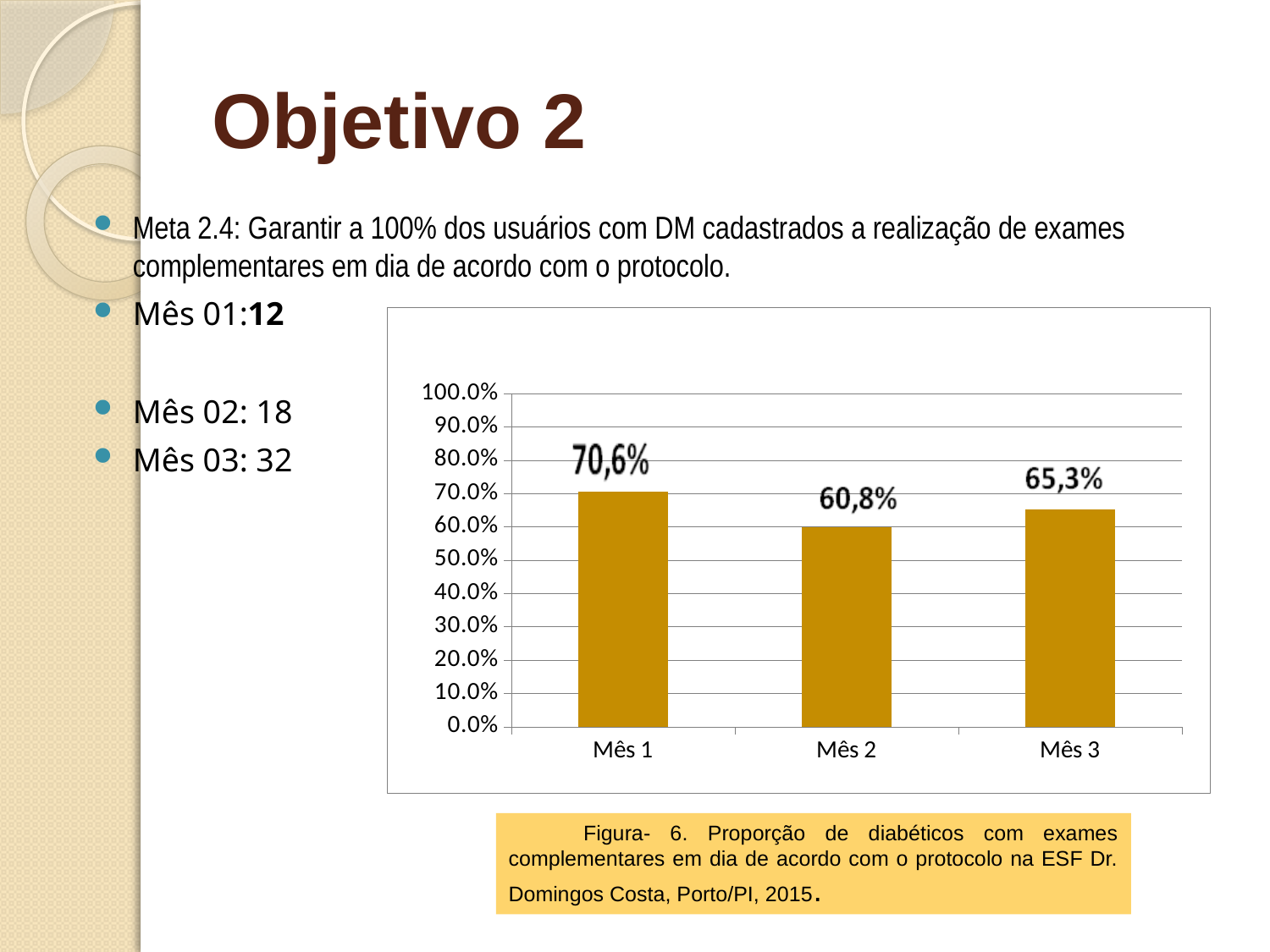
How many months are shown on the x axis? 3 Is the value for Mês 1 greater or less than 80.0%? less What is the value for Mês 1? 70,6% Which is larger, the value for Mês 2 or the value for Mês 3? Mês 3 Which month has the lowest value? Mês 2 Does the value rise or fall from Mês 1 to Mês 2? fall What is the value for Mês 3? 65,3% What is the value for Mês 2? 60,8% What kind of chart is shown on the slide? bar chart What is the difference between the values for Mês 3 and Mês 2? 4,5% Which month has the highest value? Mês 1 What is the difference between the values for Mês 1 and Mês 2? 9,8%